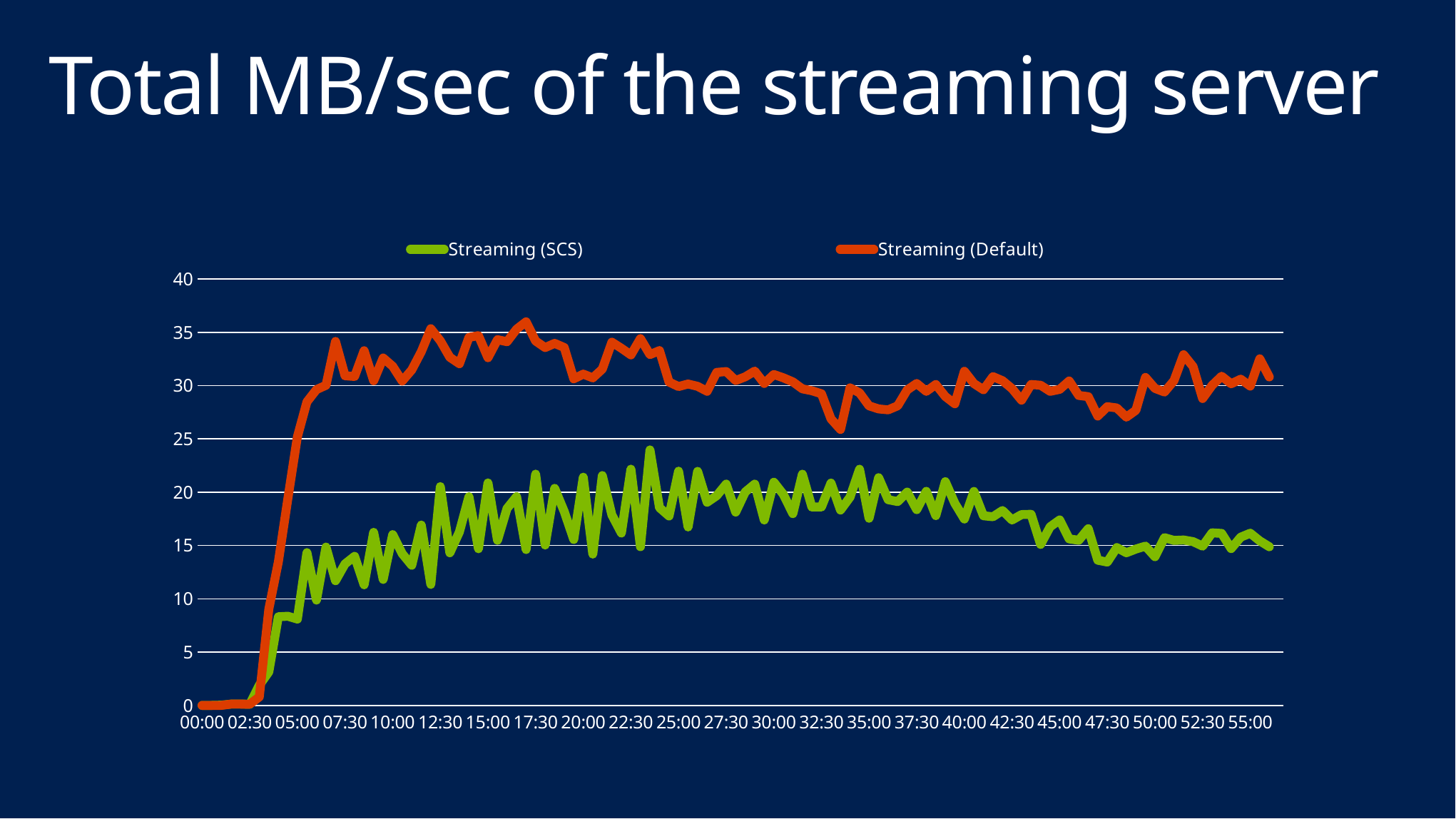
What is the title of the chart? Total MB/sec of the streaming server How many series does the legend list? 2 Is the value for Streaming (SCS) at 22:30 greater or less than 20? greater What is the value of Streaming (SCS) at 00:00? 0 What kind of chart is shown on the slide? Line chart Which series is drawn in green? Streaming (SCS) Does the Streaming (SCS) line rise or fall between 40:00 and 55:00? Fall Is the value for Streaming (SCS) at 07:30 greater or less than 20? less Does the Streaming (Default) line rise or fall between 00:00 and 07:30? Rise Is the value for Streaming (Default) at 10:00 greater or less than 30? greater At 30:00, which series has the higher value, Streaming (SCS) or Streaming (Default)? Streaming (Default)